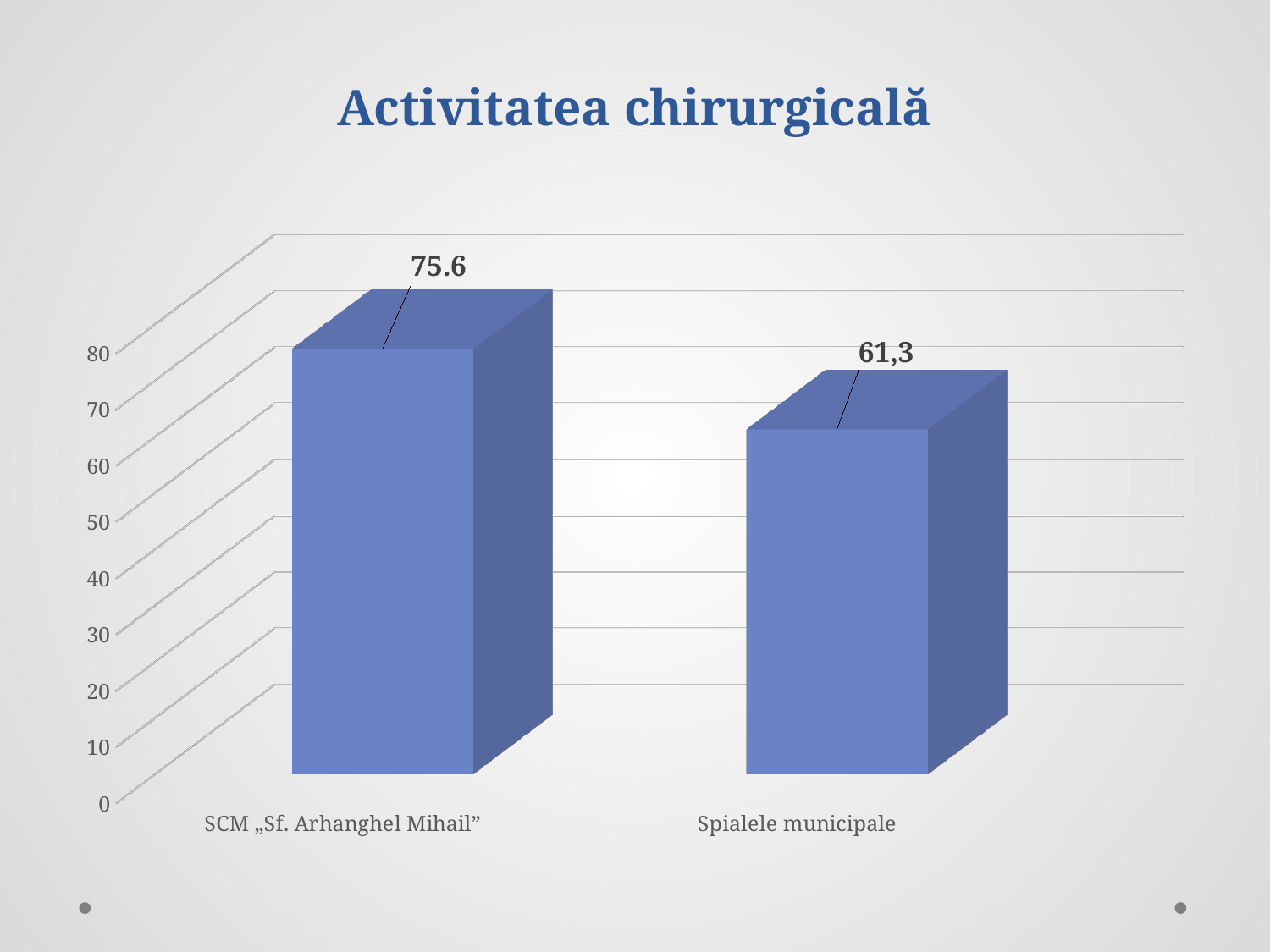
What is the difference between the value for SCM „Sf. Arhanghel Mihail” and the value for Spialele municipale? 14.3 What is the value for Spialele municipale? 61,3 Is the value for Spialele municipale greater or less than 70? less Which category has the lowest value? Spialele municipale What kind of chart is shown on the slide? bar chart Is the value for Spialele municipale greater or less than 50? greater Which is larger, the value for SCM „Sf. Arhanghel Mihail” or the value for Spialele municipale? SCM „Sf. Arhanghel Mihail” What is the title of the slide? Activitatea chirurgicală What is the value for SCM „Sf. Arhanghel Mihail”? 75.6 How many categories are shown in the chart? 2 Is the value for SCM „Sf. Arhanghel Mihail” greater or less than 70? greater Which category has the highest value? SCM „Sf. Arhanghel Mihail”